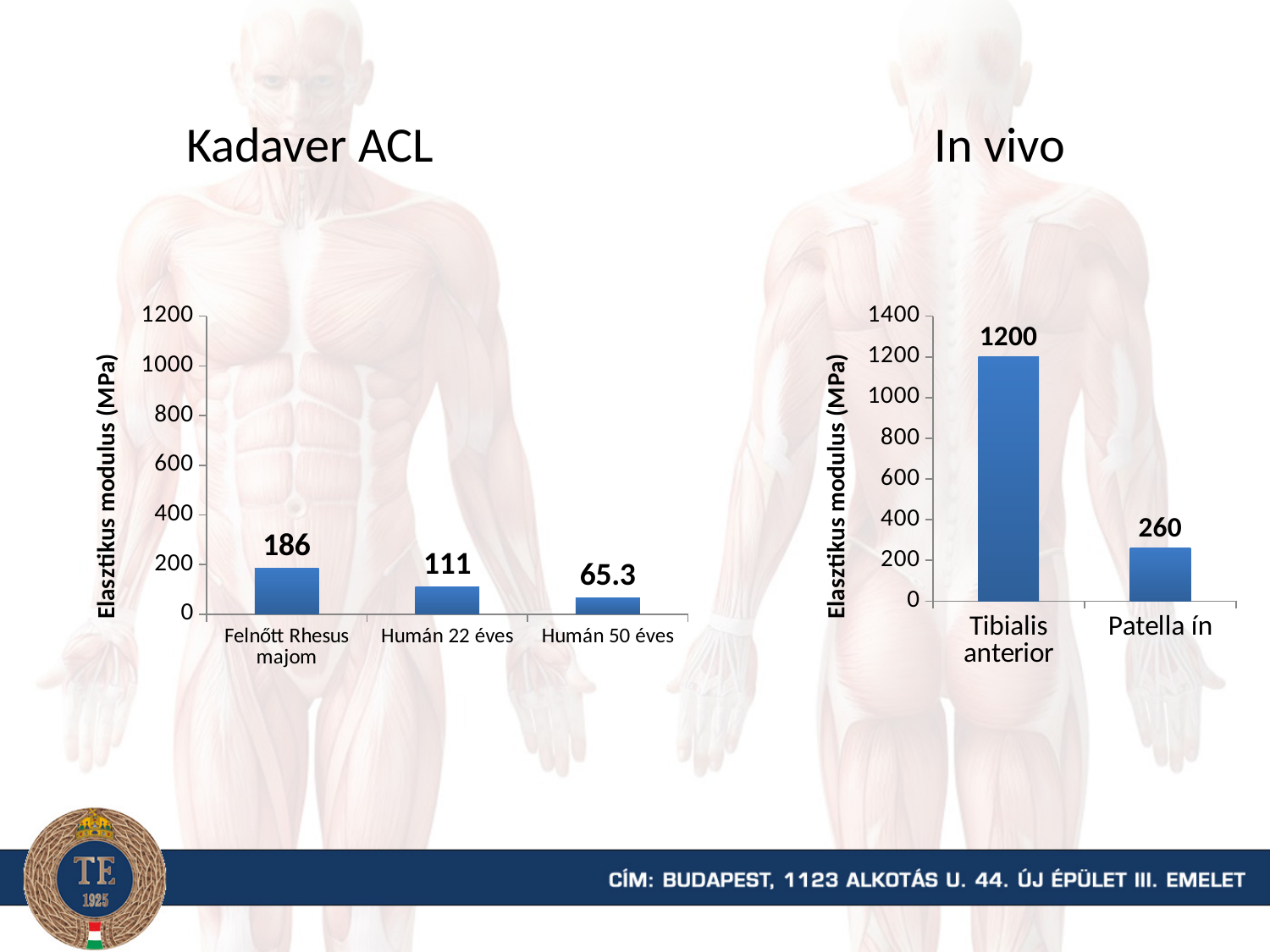
What is the y-axis label of the Kadaver ACL chart? Elasztikus modulus (MPa) What type of chart is the In vivo chart? Bar chart In the Kadaver ACL chart, which category has the lowest value? Humán 50 éves In the Kadaver ACL chart, how many categories are shown? 3 In the Kadaver ACL chart, what is the value for Humán 50 éves? 65.3 In the In vivo chart, what is the value for Tibialis anterior? 1200 In the Kadaver ACL chart, what is the difference between the values for Felnőtt Rhesus majom and Humán 22 éves? 75 In the Kadaver ACL chart, which category has the highest value? Felnőtt Rhesus majom In the In vivo chart, which is larger, Tibialis anterior or Patella ín? Tibialis anterior In the Kadaver ACL chart, what is the elastic modulus value for Felnőtt Rhesus majom? 186 In the In vivo chart, what is the difference between Tibialis anterior and Patella ín? 940 In the In vivo chart, what is the value for Patella ín? 260